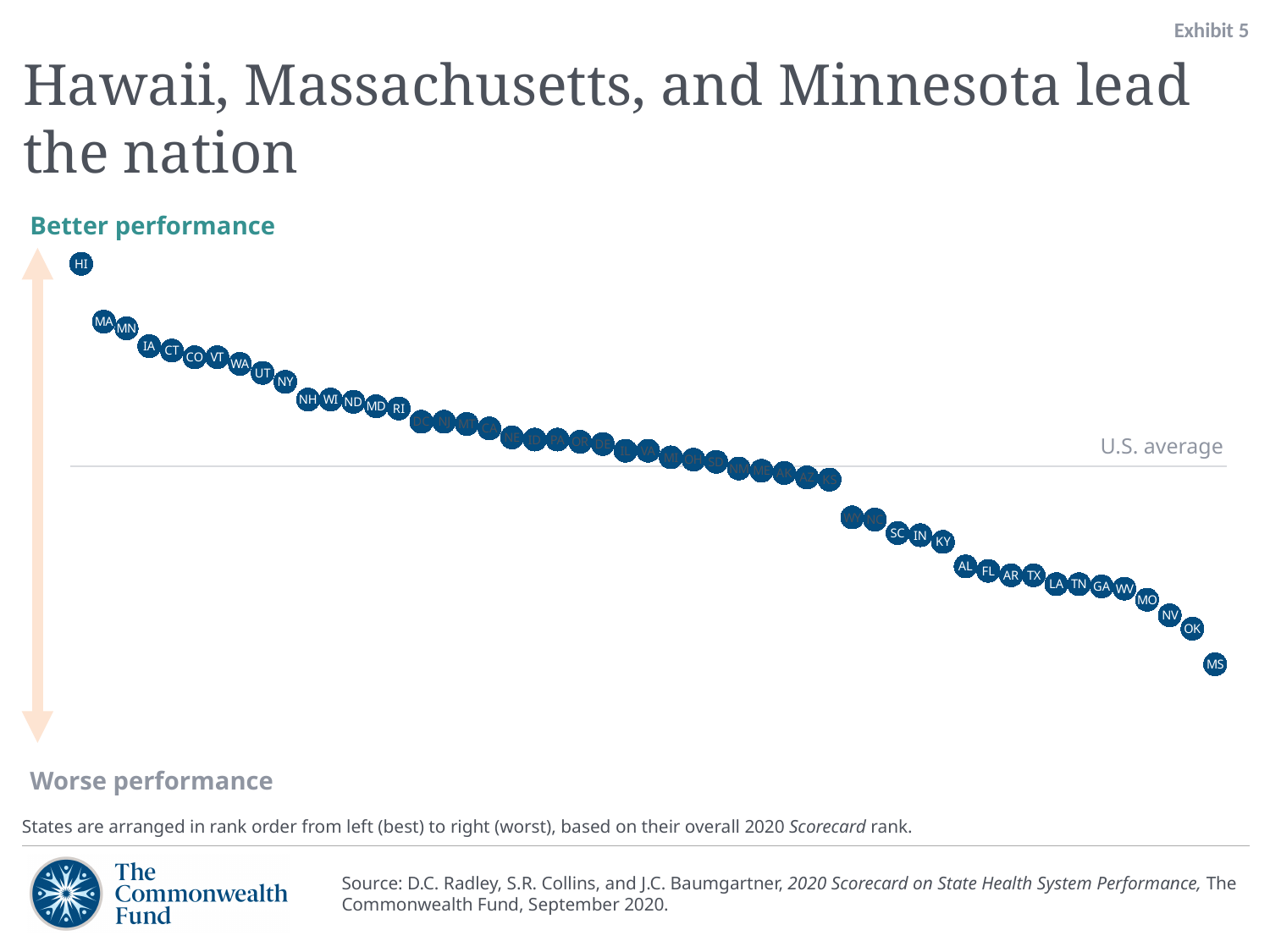
Which state is plotted highest (best performance) on the chart? HI What does the horizontal reference line on the chart represent? U.S. average Do the plotted points rise or fall moving from left to right along the chart? Fall What kind of chart is shown on the slide? Scatter chart Which state is plotted lower on the chart, NV or IA? NV Which state is plotted higher on the chart, MA or OK? MA Which state is plotted immediately to the right of HI? MA What is the title of the slide? Hawaii, Massachusetts, and Minnesota lead the nation Which state is plotted immediately to the left of MS? OK Which state is plotted higher on the chart, HI or MN? HI Which state is plotted lowest (worst performance) on the chart? MS